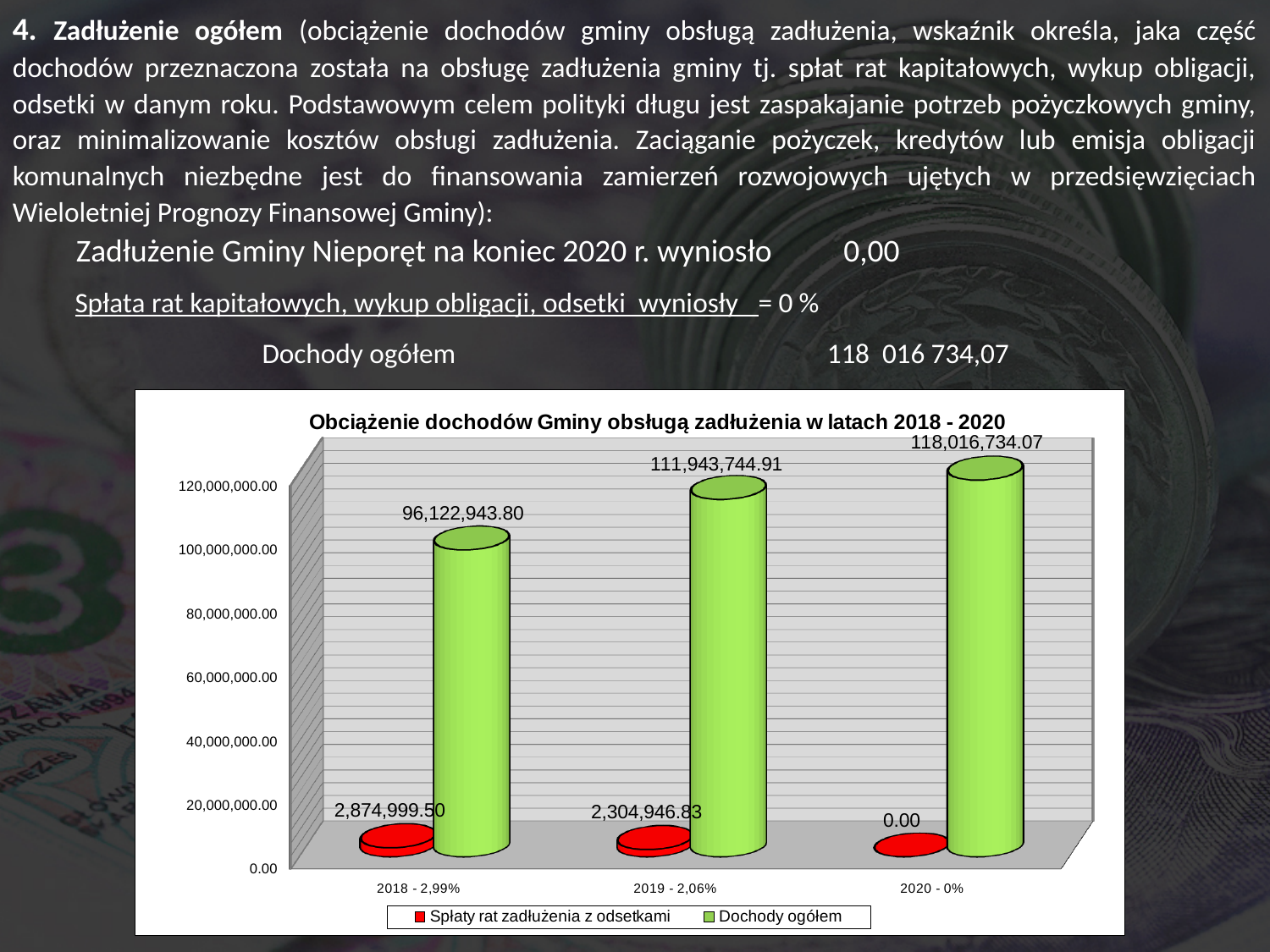
What is the value of Spłaty rat zadłużenia z odsetkami for 2020 - 0%? 0.00 Which category has the lowest value for Spłaty rat zadłużenia z odsetkami? 2020 - 0% What type of chart is shown on the slide? bar chart What is the value of Spłaty rat zadłużenia z odsetkami for 2019 - 2,06%? 2,304,946.83 How many categories are shown on the x axis of the chart? 3 Do the values for Dochody ogółem rise or fall from 2018 to 2020? rise Which is larger: Spłaty rat zadłużenia z odsetkami in 2018 - 2,99% or in 2019 - 2,06%? 2018 - 2,99% Which category has the highest value for Dochody ogółem? 2020 - 0% What is the title of the chart? Obciążenie dochodów Gminy obsługą zadłużenia w latach 2018 - 2020 How many series does the chart legend list? 2 What is the difference between Dochody ogółem in 2020 - 0% and in 2019 - 2,06%? 6,072,989.16 What is the value of Dochody ogółem for 2018 - 2,99%? 96,122,943.80